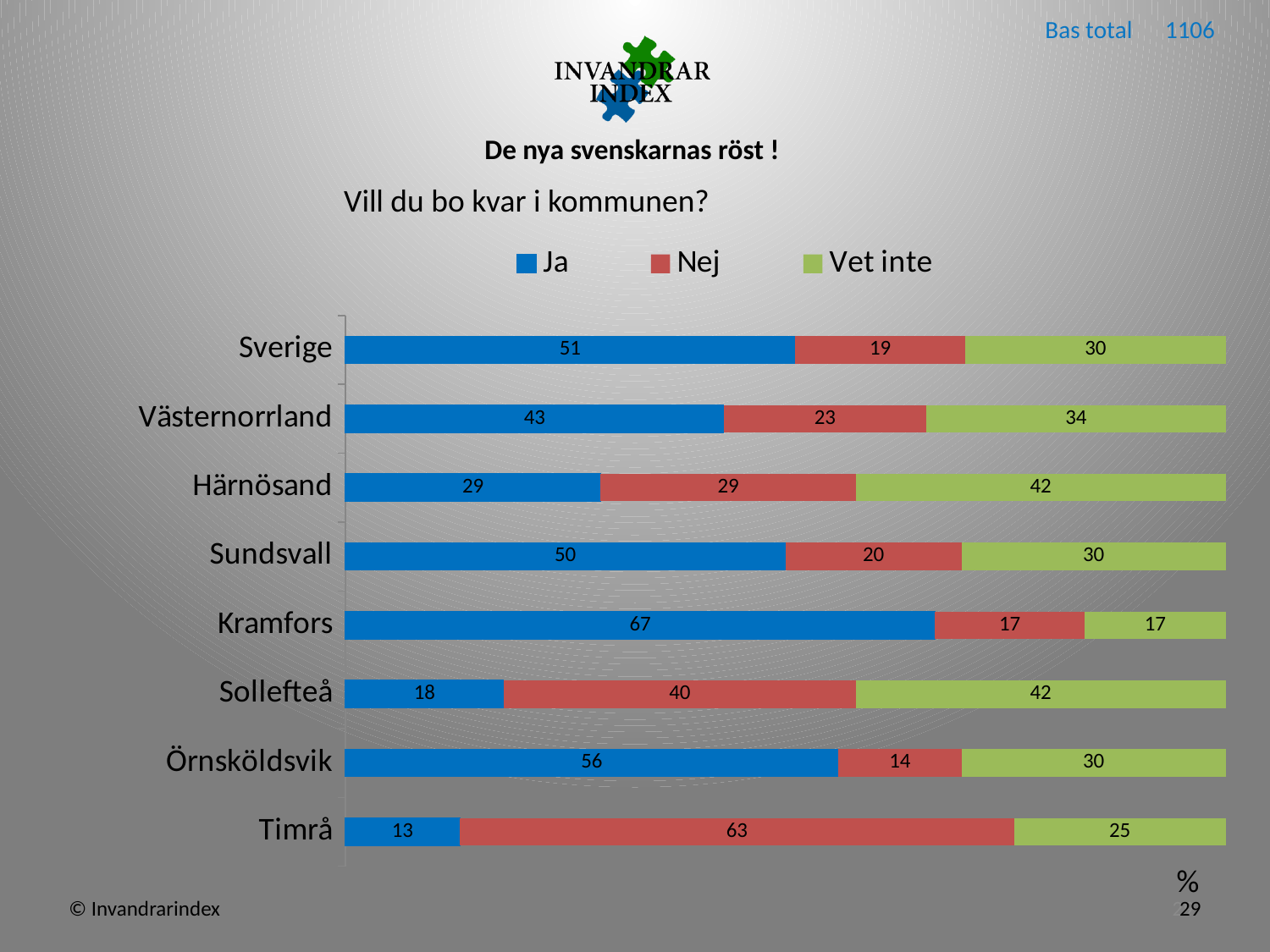
What is the value for Vet inte for Härnösand? 42 Which category has the highest value for Ja? Kramfors How many series does the legend list? 3 What is the value for Ja for Kramfors? 67 What is the difference between the Ja values for Sverige and Västernorrland? 8 What is the total of the stacked bar for Örnsköldsvik? 100 What is the value for Nej for Timrå? 63 Which is larger, the Nej value for Sollefteå or the Nej value for Sundsvall? Sollefteå What is the title of the chart? Vill du bo kvar i kommunen? How many categories are shown on the chart? 8 Which category has the lowest value for Ja? Timrå What kind of chart is shown on the slide? Stacked bar chart